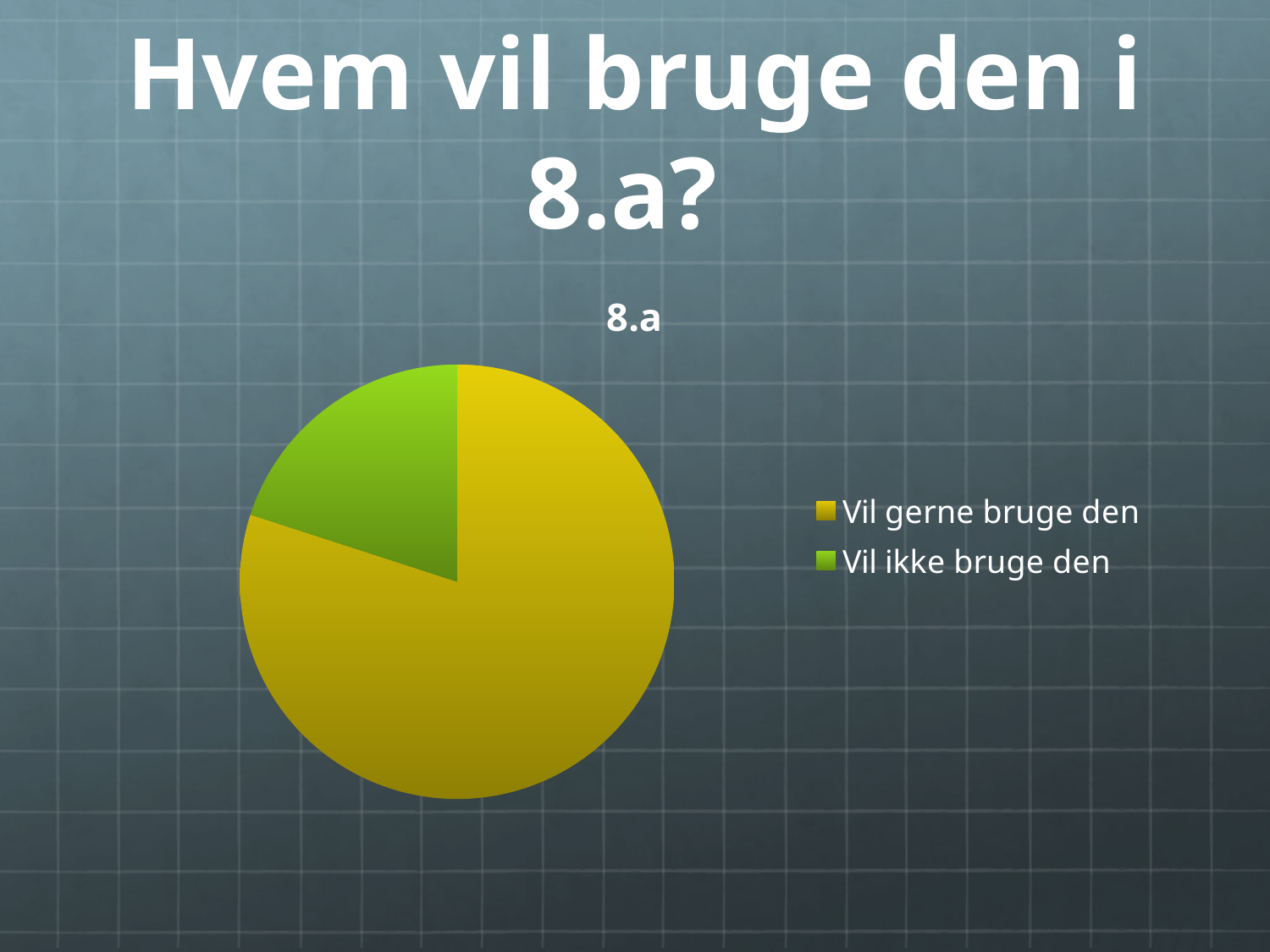
What colour is the slice for "Vil ikke bruge den"? green How many entries does the legend list? 2 What kind of chart is shown on the slide? pie chart Which category has the largest slice of the pie? Vil gerne bruge den Which category has the smallest slice of the pie? Vil ikke bruge den What is the title of the chart? 8.a How many slices does the pie chart have? 2 Which slice is larger, "Vil gerne bruge den" or "Vil ikke bruge den"? Vil gerne bruge den